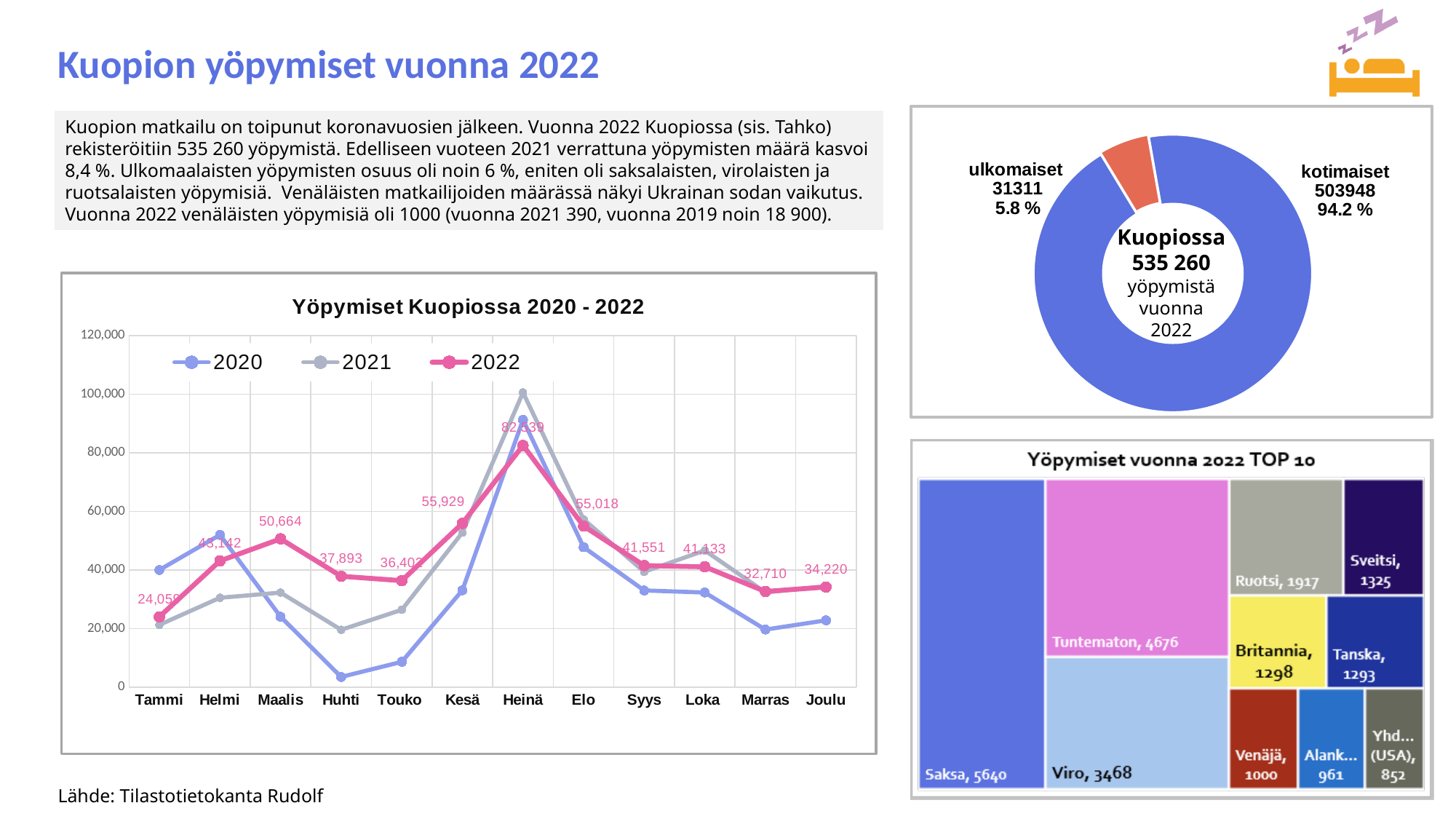
In the donut chart at the top right, what share of overnight stays is 'ulkomaiset'? 5.8 % What kind of chart is 'Yöpymiset Kuopiossa 2020 - 2022'? line chart In the line chart 'Yöpymiset Kuopiossa 2020 - 2022', which month has the highest 2022 value? Heinä In the donut chart at the top right, what is the value for 'kotimaiset'? 503948 How many series does the legend of the line chart 'Yöpymiset Kuopiossa 2020 - 2022' list? 3 How many months are shown on the x axis of the line chart 'Yöpymiset Kuopiossa 2020 - 2022'? 12 In the line chart 'Yöpymiset Kuopiossa 2020 - 2022', what is the 2022 value for Elo? 55,018 In the line chart 'Yöpymiset Kuopiossa 2020 - 2022', is the 2021 value for Heinä greater or less than 80,000? greater In the chart 'Yöpymiset vuonna 2022 TOP 10', which is larger, Britannia or Tanska? Britannia In the line chart 'Yöpymiset Kuopiossa 2020 - 2022', what is the difference between the 2022 values for Kesä and Elo? 911 In the line chart 'Yöpymiset Kuopiossa 2020 - 2022', is the 2020 value for Huhti greater or less than 20,000? less In the line chart 'Yöpymiset Kuopiossa 2020 - 2022', what is the 2022 value for Maalis? 50,664